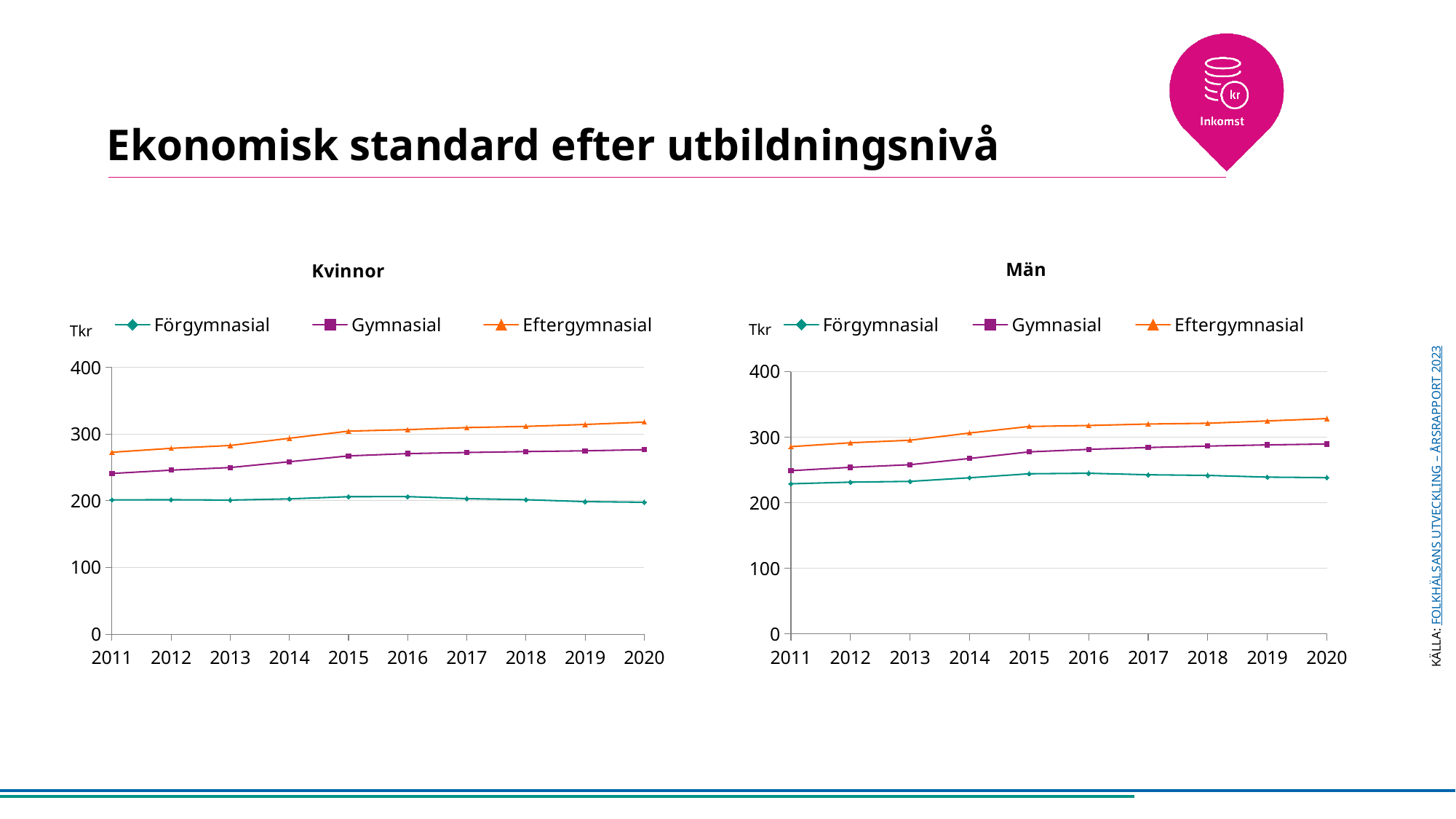
In the Kvinnor chart, is the value for Eftergymnasial in 2020 greater or less than 300? greater How many years are shown on the x axis of the Kvinnor chart? 10 In the Män chart, is the value for Förgymnasial in 2011 greater or less than 200? greater In the Kvinnor chart, does the Eftergymnasial series rise or fall from 2011 to 2020? rise In the Kvinnor chart, is the value for Gymnasial in 2011 greater or less than 300? less In the Kvinnor chart, which series has the highest values across all years? Eftergymnasial In the Män chart, which series has the lowest values across all years? Förgymnasial What type of chart is the Kvinnor chart? line chart In the Män chart, which is larger in 2020: Gymnasial or Förgymnasial? Gymnasial How many series does the legend of the Män chart list? 3 What unit label is shown at the top of the y axis on both charts? Tkr